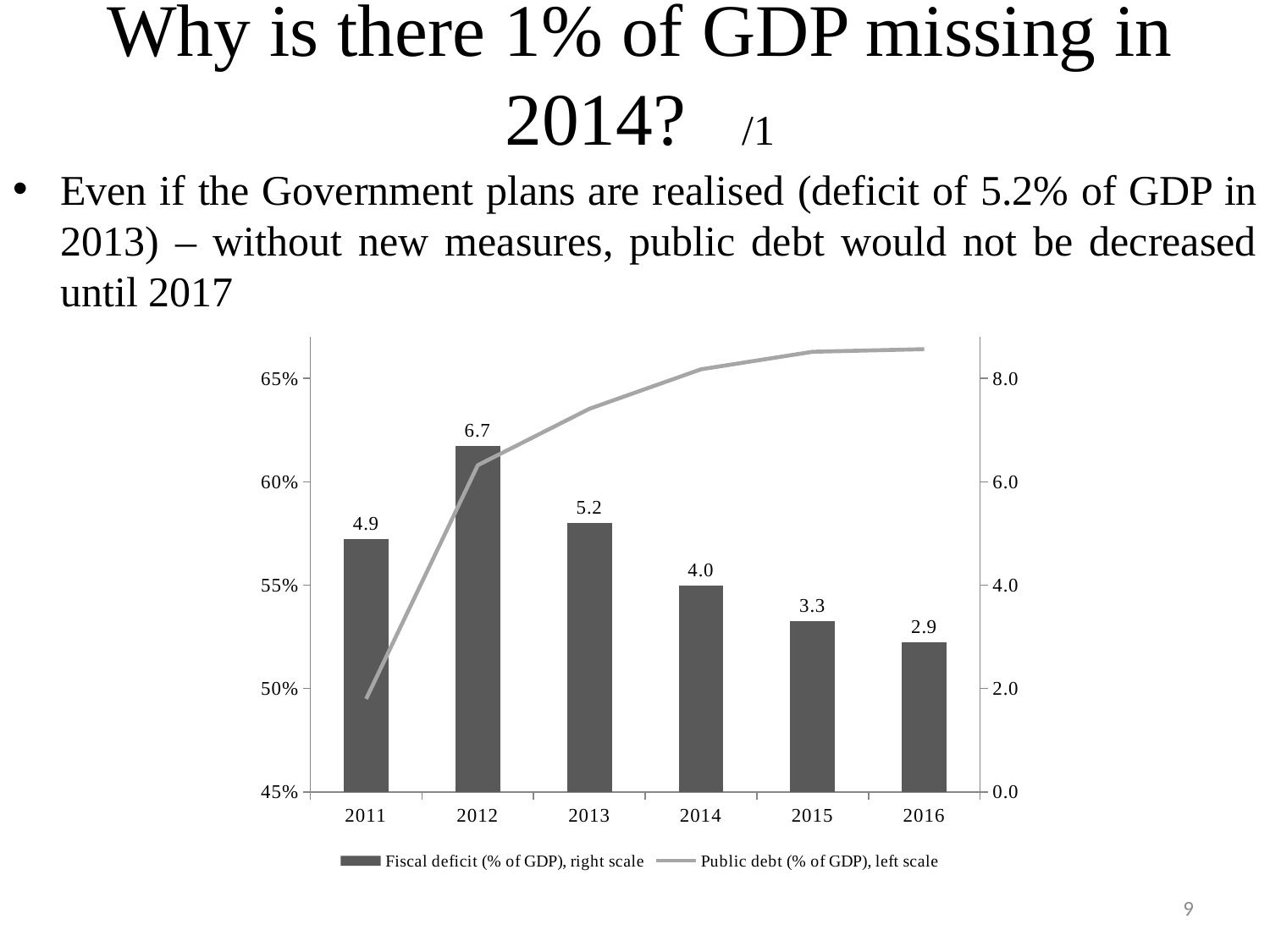
Is the value for public debt (% of GDP) in 2014 greater or less than 65%? greater Which year has the lowest fiscal deficit (% of GDP)? 2016 What is the fiscal deficit (% of GDP) for 2012? 6.7 Which year has the highest fiscal deficit (% of GDP)? 2012 Is the value for public debt (% of GDP) in 2011 greater or less than 50%? less What is the difference between the fiscal deficit in 2012 and in 2013? 1.5 Does the fiscal deficit rise or fall from 2012 to 2016? fall How many years are shown on the x axis of the chart? 6 What is the fiscal deficit (% of GDP) for 2014? 4.0 What is the fiscal deficit (% of GDP) for 2016? 2.9 Which is larger, the fiscal deficit in 2011 or in 2013? 2013 How many series does the chart legend list? 2